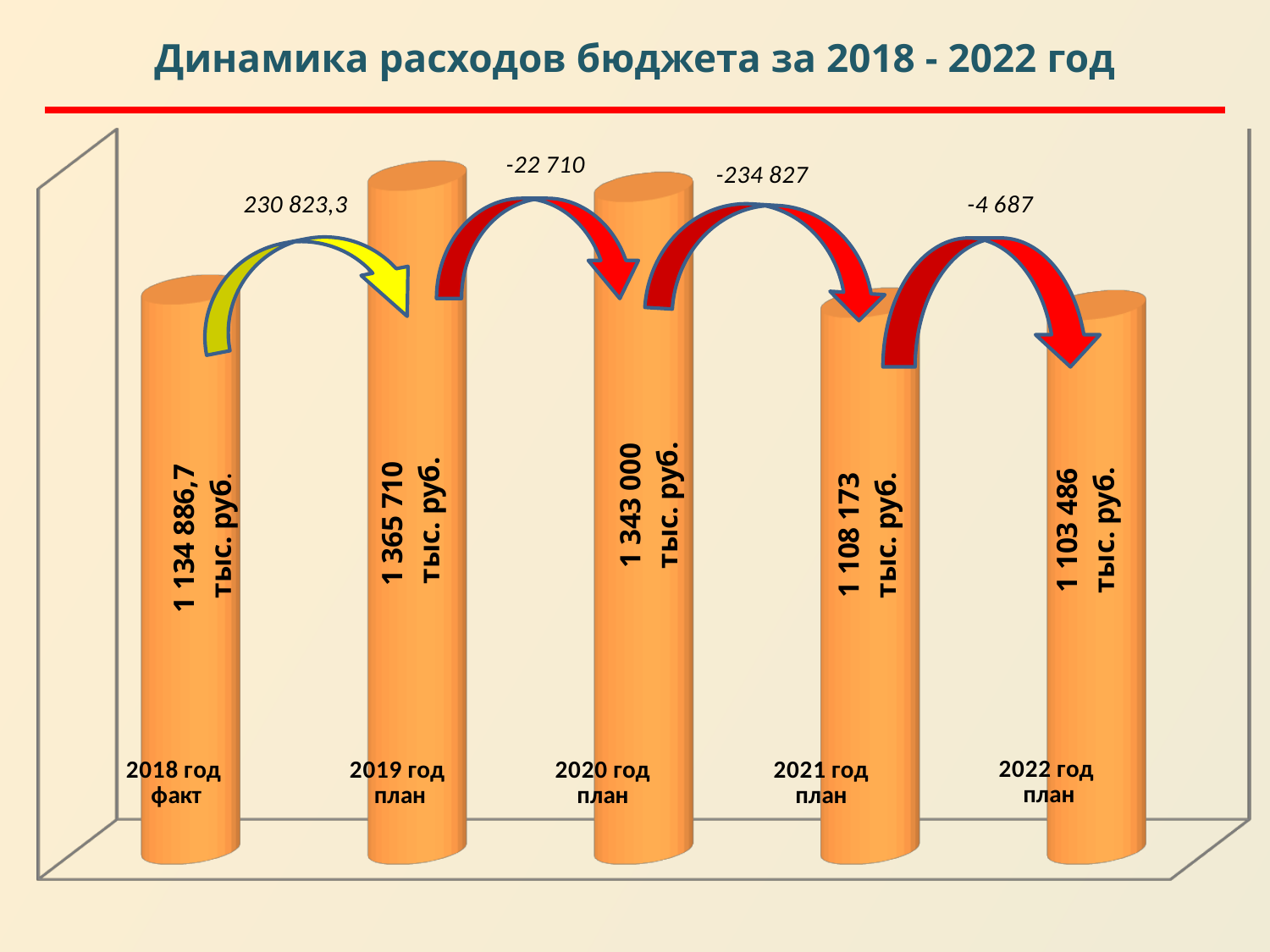
Which year has the highest budget expenditure value? 2019 год план What is the budget expenditure value shown for 2022 год план? 1 103 486 тыс. руб. What is the title of the chart? Динамика расходов бюджета за 2018 - 2022 год Which is larger, the value for 2021 год план or the value for 2022 год план? 2021 год план What kind of chart is shown on the slide? Bar chart By how much does the value for 2019 год план exceed the value for 2018 год факт? 230 823,3 What is the change in expenditure from 2020 год план to 2021 год план, as labelled on the arrow? -234 827 What is the budget expenditure value shown for 2020 год план? 1 343 000 тыс. руб. What is the change in expenditure from 2019 год план to 2020 год план, as labelled on the arrow? -22 710 Which year has the lowest budget expenditure value? 2022 год план How many years (bars) are shown in the chart? 5 What is the budget expenditure value shown for 2018 год факт? 1 134 886,7 тыс. руб.